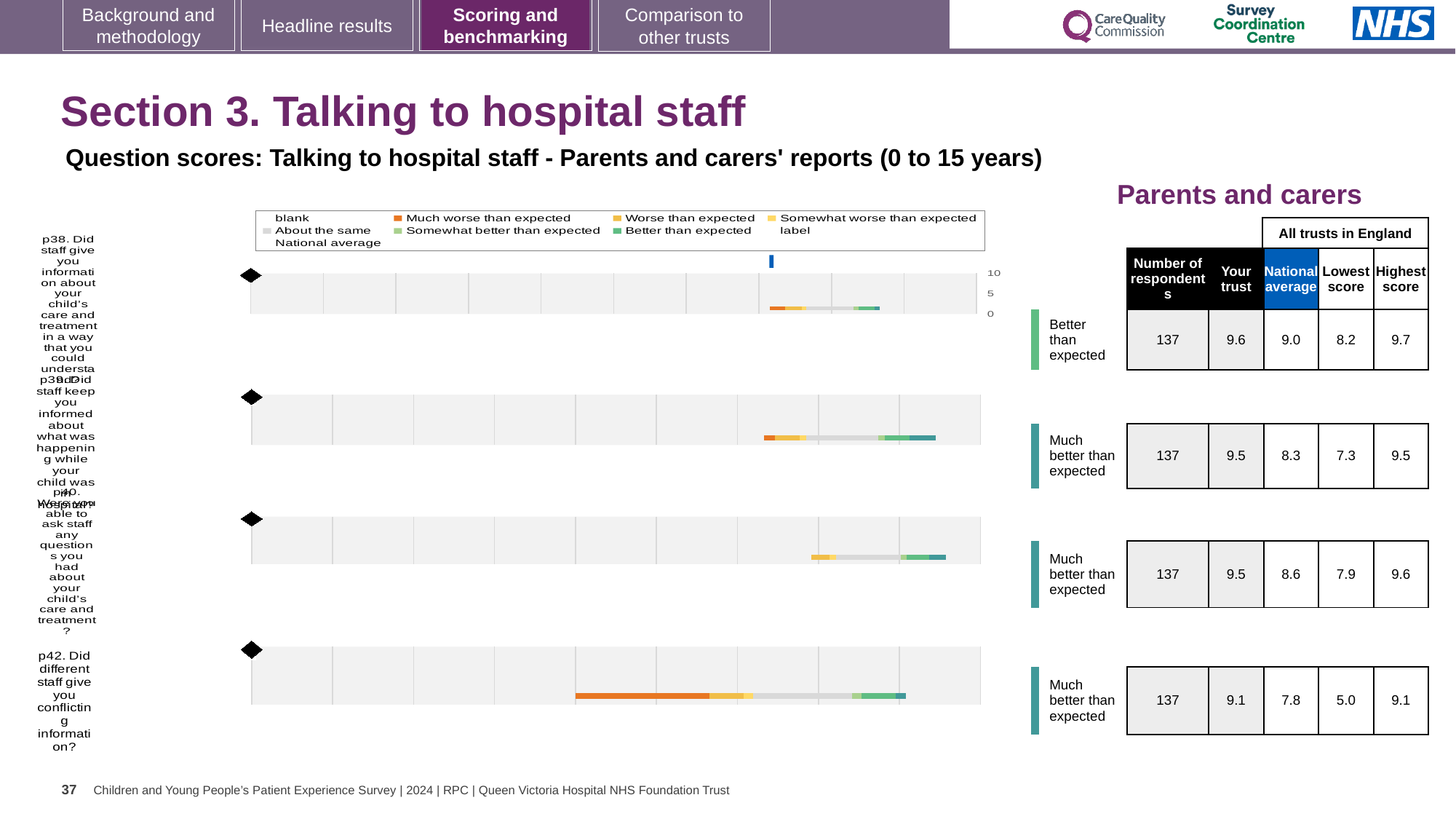
For p42, what is the difference between the highest score and the lowest score? 4.1 How many survey questions (charts) are plotted on the slide? 4 How many entries does the chart legend list? 9 For p38, how many respondents are shown in the table? 137 What is the subtitle above the charts? Question scores: Talking to hospital staff - Parents and carers' reports (0 to 15 years) Which question has the highest 'Your trust' score? p38 For p42 (conflicting information), what is the 'Your trust' score? 9.1 For p38, which is larger: the 'Your trust' score or the national average? Your trust What kind of chart is used to show the p38 question scores? bar chart Which question has the lowest 'Lowest score' value? p42 Which colour in the legend represents 'Much worse than expected'? orange For p39 (staff keep you informed), what is the national average score? 8.3